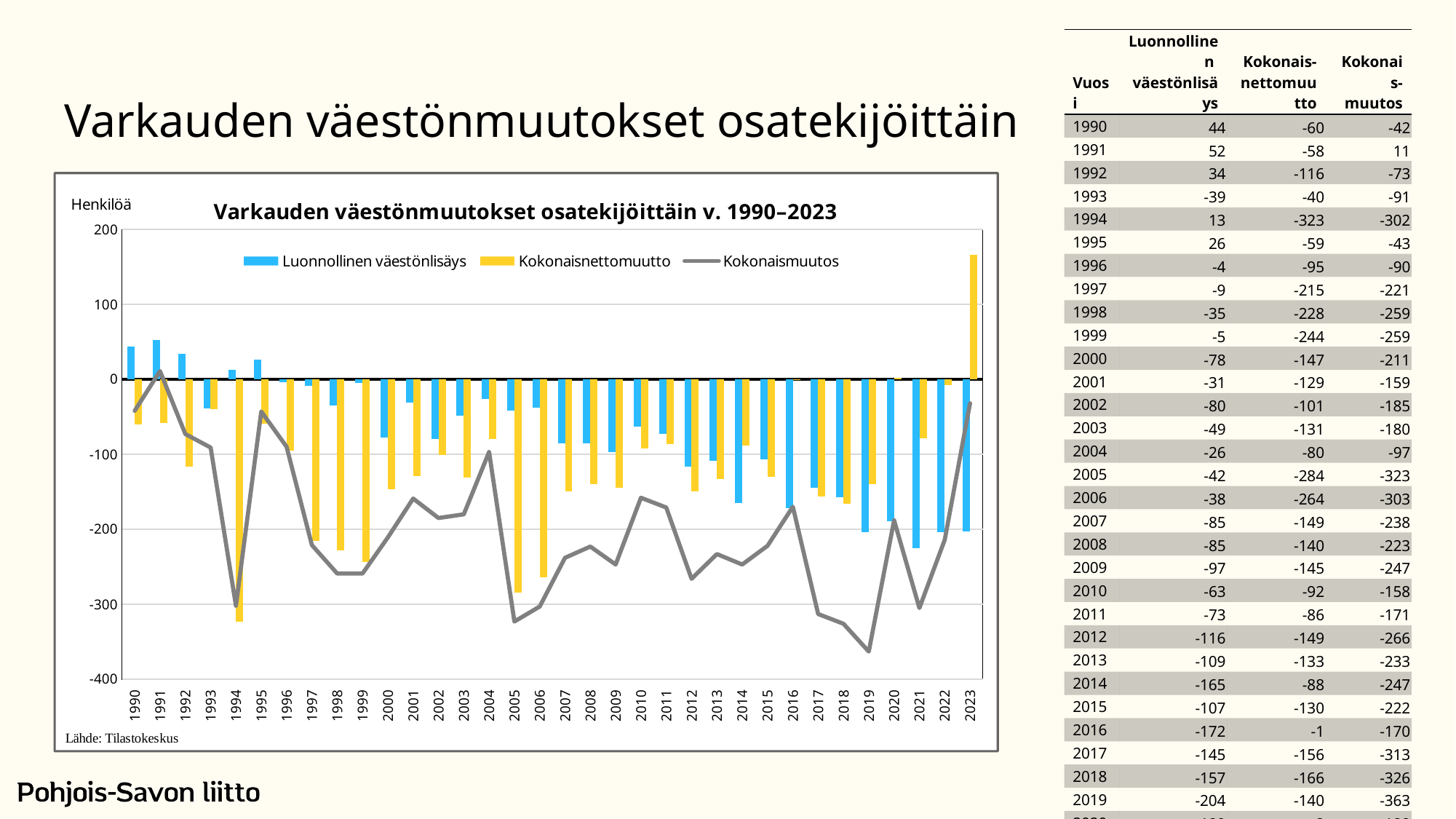
Is the value of Kokonaisnettomuutto for 2023 greater or less than 100? greater In which year is Kokonaismuutos at its lowest? 2019 How many series does the chart legend list? 3 What is the value of Luonnollinen väestönlisäys for 1990? 44 What is the value of Kokonaismuutos for 2019? -363 Which colour represents Kokonaisnettomuutto in the chart? Yellow What kind of chart is shown on the slide? A combined bar and line chart How many years are plotted along the x axis of the chart? 34 Which is larger, Luonnollinen väestönlisäys in 2015 or in 2016? 2015 What is the difference between Luonnollinen väestönlisäys and Kokonaisnettomuutto in 1990? 104 In which year is Kokonaisnettomuutto at its highest? 2023 What is the value of Kokonaisnettomuutto for 1994? -323